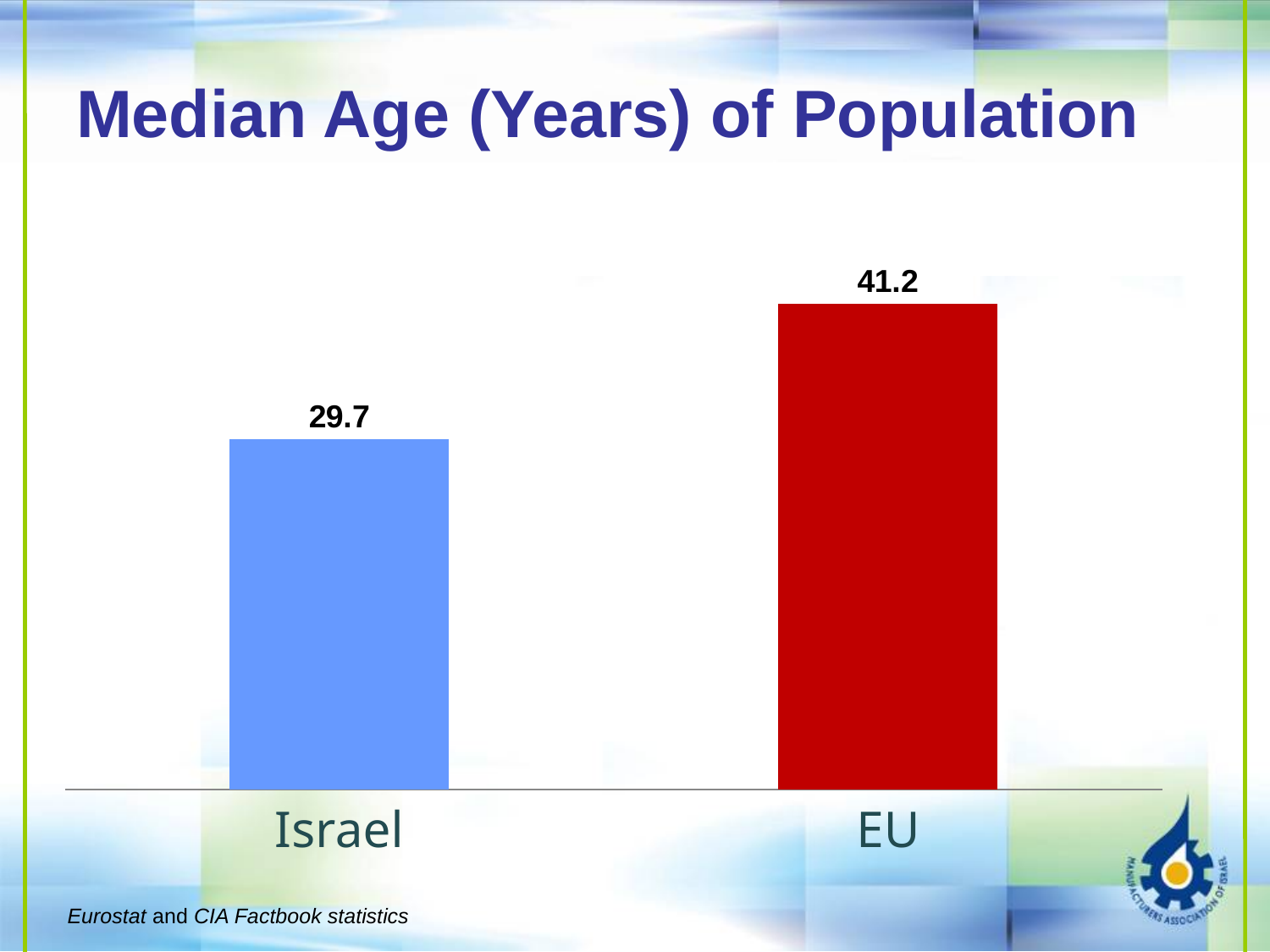
What is the median age shown for the EU? 41.2 What is the median age shown for Israel? 29.7 How many categories are shown in the chart? 2 What is the difference between the median age of the EU and that of Israel? 11.5 Which category has the higher median age? EU What colour is the bar for the EU? red Which category has the lower median age? Israel Is the median age for Israel larger or smaller than that for the EU? smaller What is the title of the chart? Median Age (Years) of Population What kind of chart is shown on the slide? bar chart